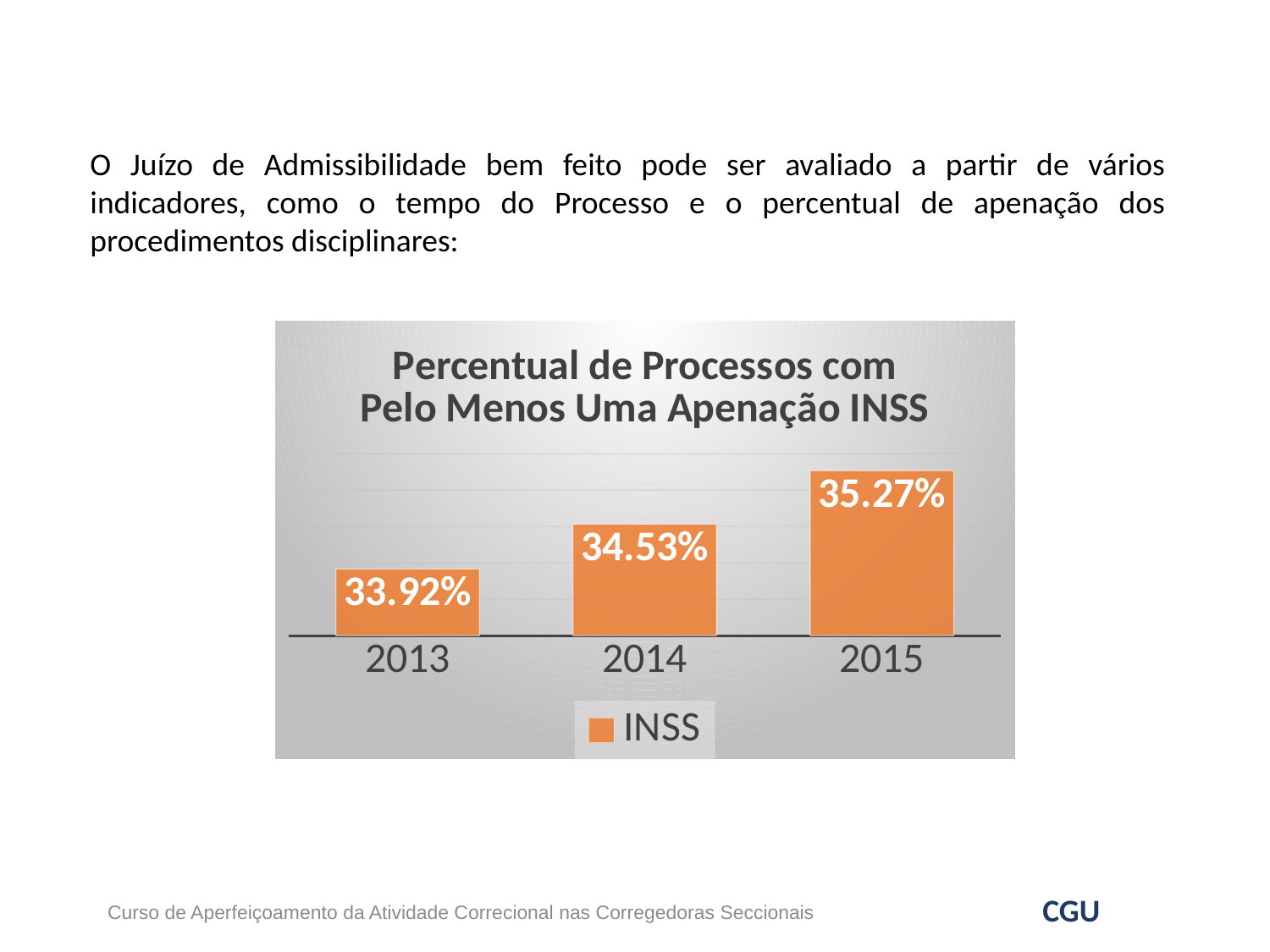
Which year has the lowest percentage? 2013 What is the difference between the values for 2014 and 2013? 0.61% What is the difference between the values for 2015 and 2013? 1.35% What kind of chart is shown? bar chart What is the value for 2013? 33.92% What is the value for 2015? 35.27% Which year has the highest percentage? 2015 How many years are shown on the x axis? 3 Which is larger, the value for 2014 or the value for 2015? 2015 Do the values rise or fall from 2013 to 2015? rise How many series does the legend list? 1 What is the value for 2014? 34.53%